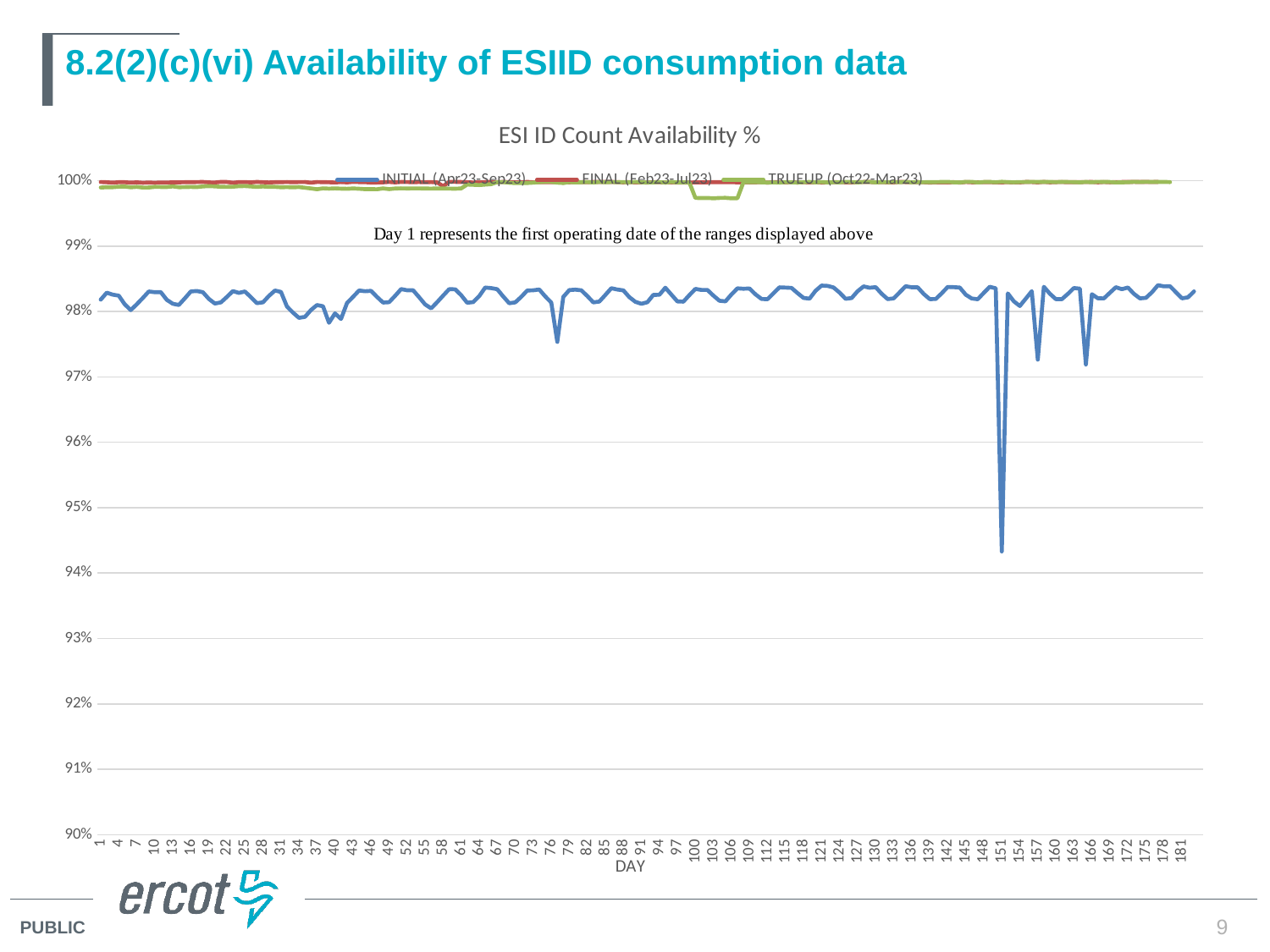
How many series does the legend list? 3 Which series is drawn in blue? INITIAL (Apr23-Sep23) Which series reaches the lowest value anywhere on the chart? INITIAL (Apr23-Sep23) Is the value of the INITIAL (Apr23-Sep23) series at its dip near day 76 greater or less than 98%? less Is the value of the TRUEUP (Oct22-Mar23) series at day 100 greater or less than 99%? greater Is the value of the INITIAL (Apr23-Sep23) series at day 151 greater or less than 96%? less At day 151, which series has the larger value: INITIAL (Apr23-Sep23) or FINAL (Feb23-Jul23)? FINAL (Feb23-Jul23) What kind of chart is shown on the slide? line chart What is the title of the chart? ESI ID Count Availability %